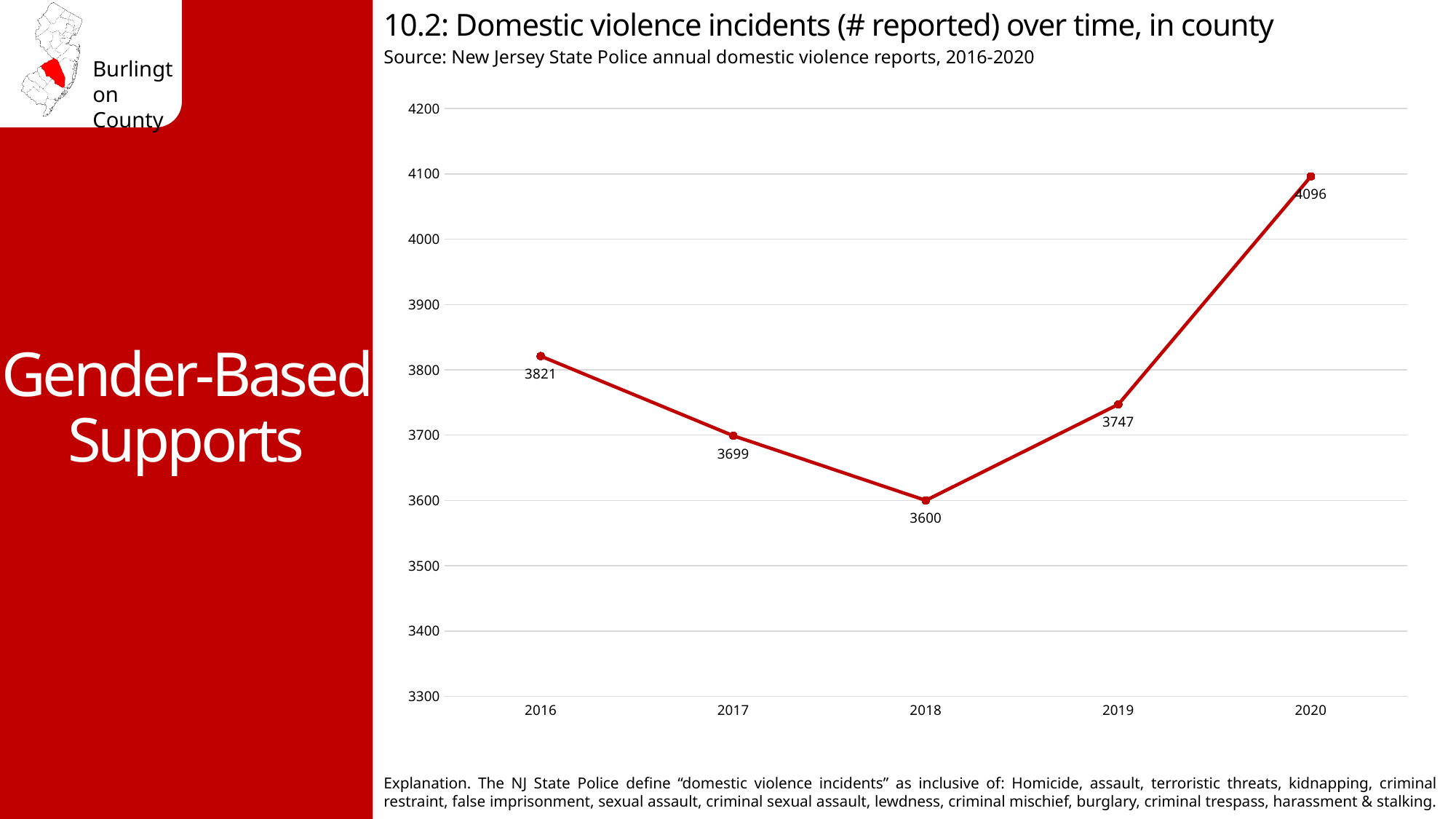
What was the number of reported domestic violence incidents in 2016? 3821 Which year had the lowest number of reported domestic violence incidents? 2018 What is the difference in reported incidents between 2016 and 2017? 122 Which year had more reported incidents, 2017 or 2019? 2019 What is the difference in reported incidents between 2020 and 2019? 349 What was the number of reported domestic violence incidents in 2018? 3600 Did the number of reported incidents rise or fall from 2018 to 2020? rise Is the value for 2020 greater or less than 4000? greater What kind of chart is shown on the slide? line chart Which year had the highest number of reported domestic violence incidents? 2020 What was the number of reported domestic violence incidents in 2020? 4096 How many years are plotted on the chart? 5